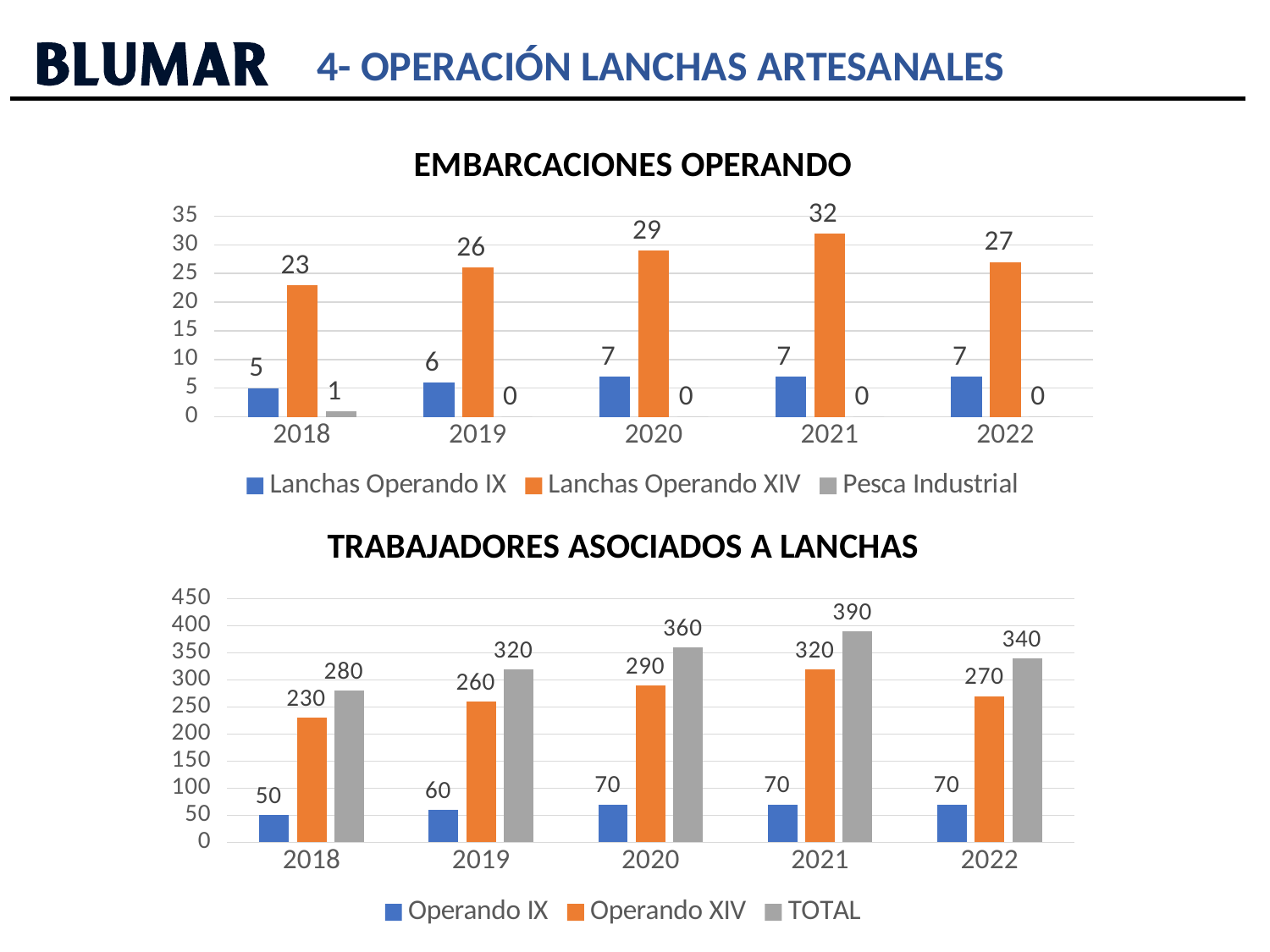
In the EMBARCACIONES OPERANDO chart, which year has the highest value for Lanchas Operando XIV? 2021 In the TRABAJADORES ASOCIADOS A LANCHAS chart, what is the TOTAL value for 2021? 390 What kind of chart is the TRABAJADORES ASOCIADOS A LANCHAS chart? Bar chart In the TRABAJADORES ASOCIADOS A LANCHAS chart, which year has the lowest TOTAL? 2018 In the TRABAJADORES ASOCIADOS A LANCHAS chart, what is the value for Operando XIV in 2019? 260 In the TRABAJADORES ASOCIADOS A LANCHAS chart, is the TOTAL for 2022 larger or smaller than the TOTAL for 2020? smaller In the EMBARCACIONES OPERANDO chart, which year has the lowest value for Lanchas Operando IX? 2018 In the TRABAJADORES ASOCIADOS A LANCHAS chart, how many years are shown on the x axis? 5 In the EMBARCACIONES OPERANDO chart, what is the difference between Lanchas Operando XIV and Lanchas Operando IX in 2020? 22 In the EMBARCACIONES OPERANDO chart, what is the value for Lanchas Operando XIV in 2021? 32 In the EMBARCACIONES OPERANDO chart, what is the value for Pesca Industrial in 2018? 1 In the EMBARCACIONES OPERANDO chart, how many series does the legend list? 3